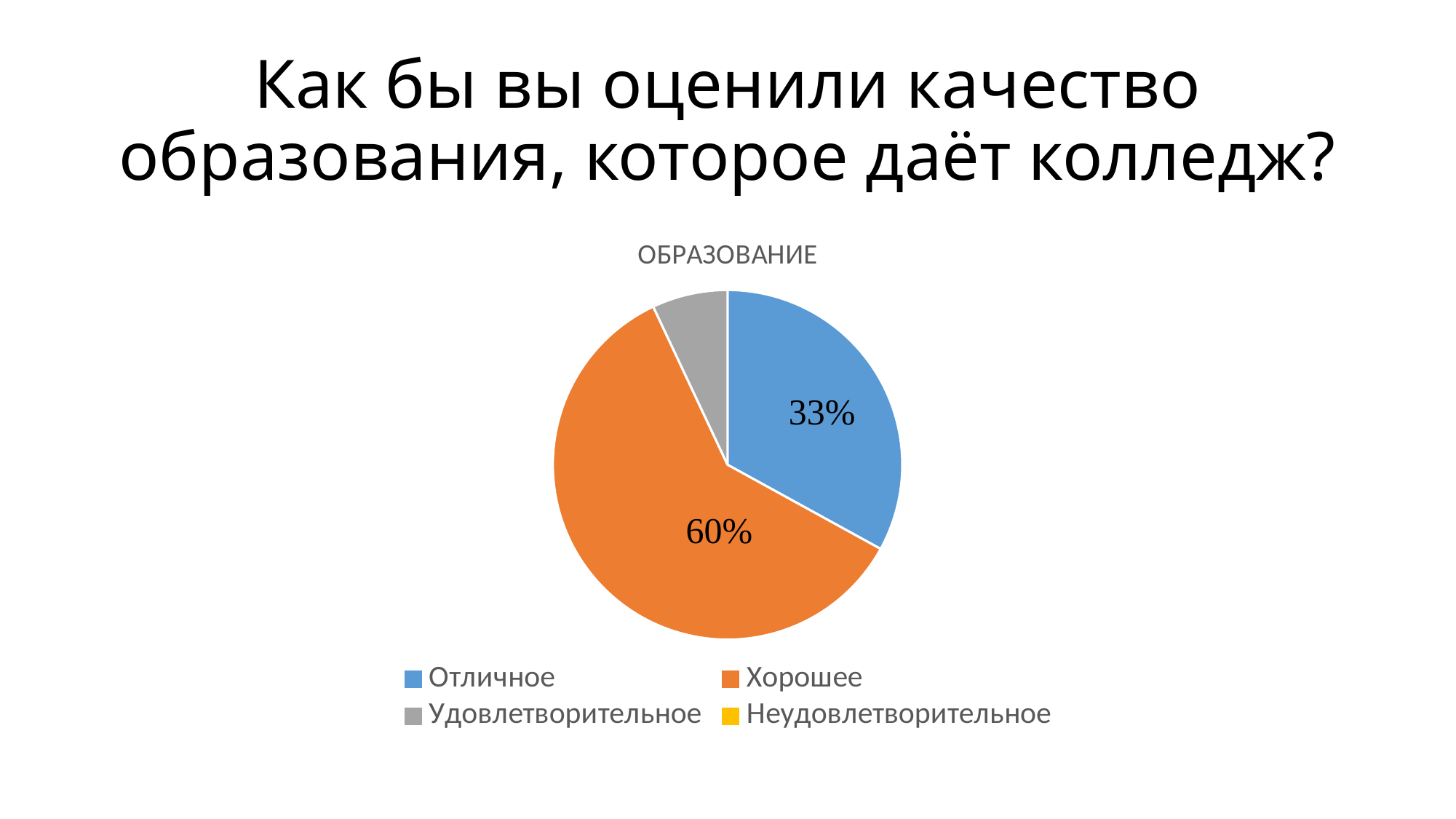
What kind of chart is shown on the slide? Pie chart Which slice is larger, Удовлетворительное or Отличное? Отличное Which slice is larger, Отличное or Хорошее? Хорошее Which category has the largest slice of the pie? Хорошее What share of the pie does the Отличное slice represent? 33% How many categories does the legend list? 4 What colour is the Хорошее slice? Orange By how many percentage points does the Хорошее share exceed the Отличное share? 27 percentage points What share of the pie does the Хорошее slice represent? 60% What is the title of the chart? ОБРАЗОВАНИЕ